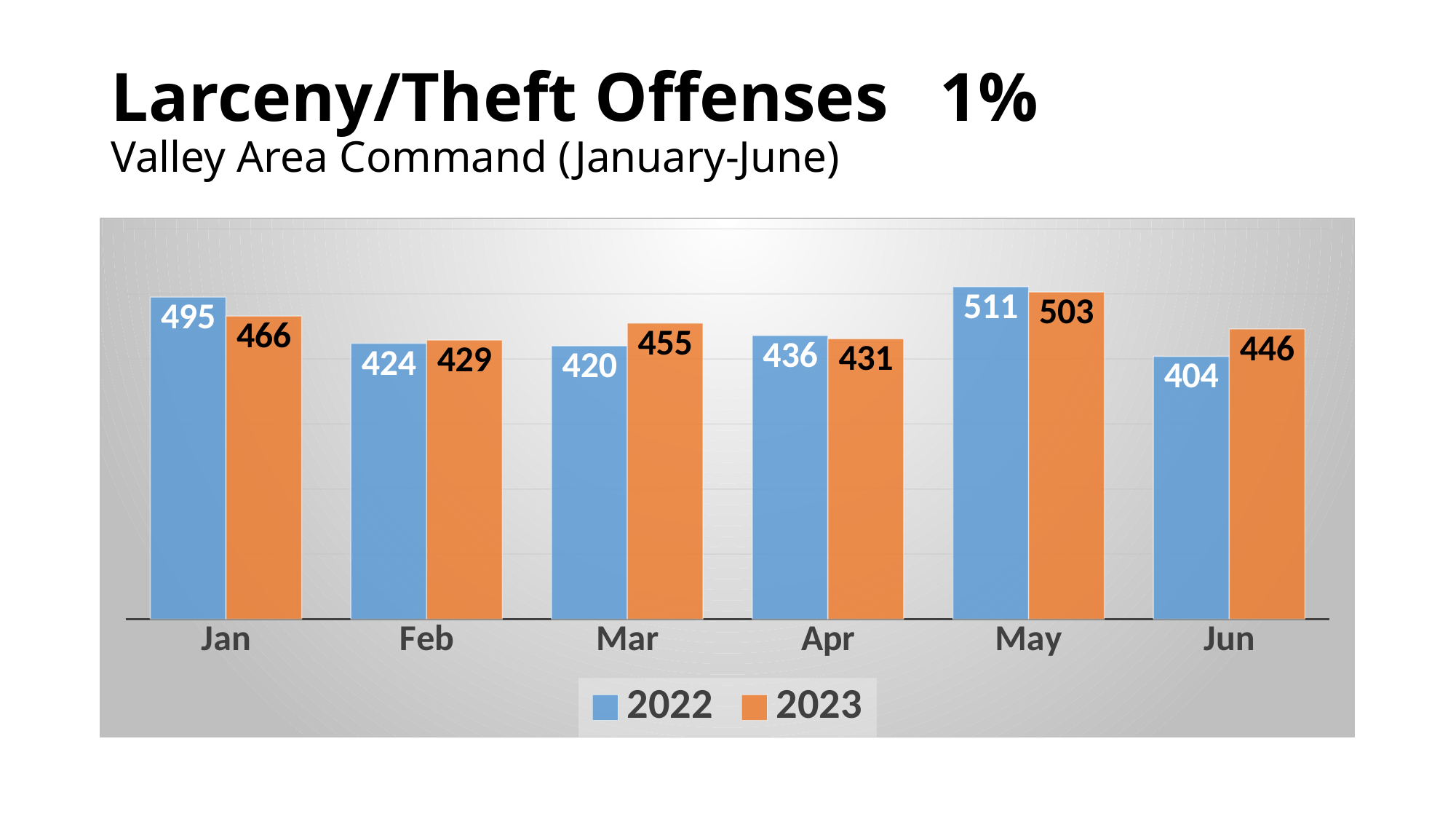
What is the value for 2022 in Jan? 495 How many months are shown on the x axis? 6 What is the value for 2023 in Jun? 446 What is the difference between the 2022 and 2023 values in Jan? 29 Which colour represents the 2023 series in the legend? orange How many series does the legend list? 2 Which month has the highest value for 2022? May Which is larger in Jun, the 2022 value or the 2023 value? 2023 What is the value for 2023 in Mar? 455 What kind of chart is shown on the slide? bar chart Which month has the lowest value for 2023? Feb What is the difference between the 2022 and 2023 values in May? 8